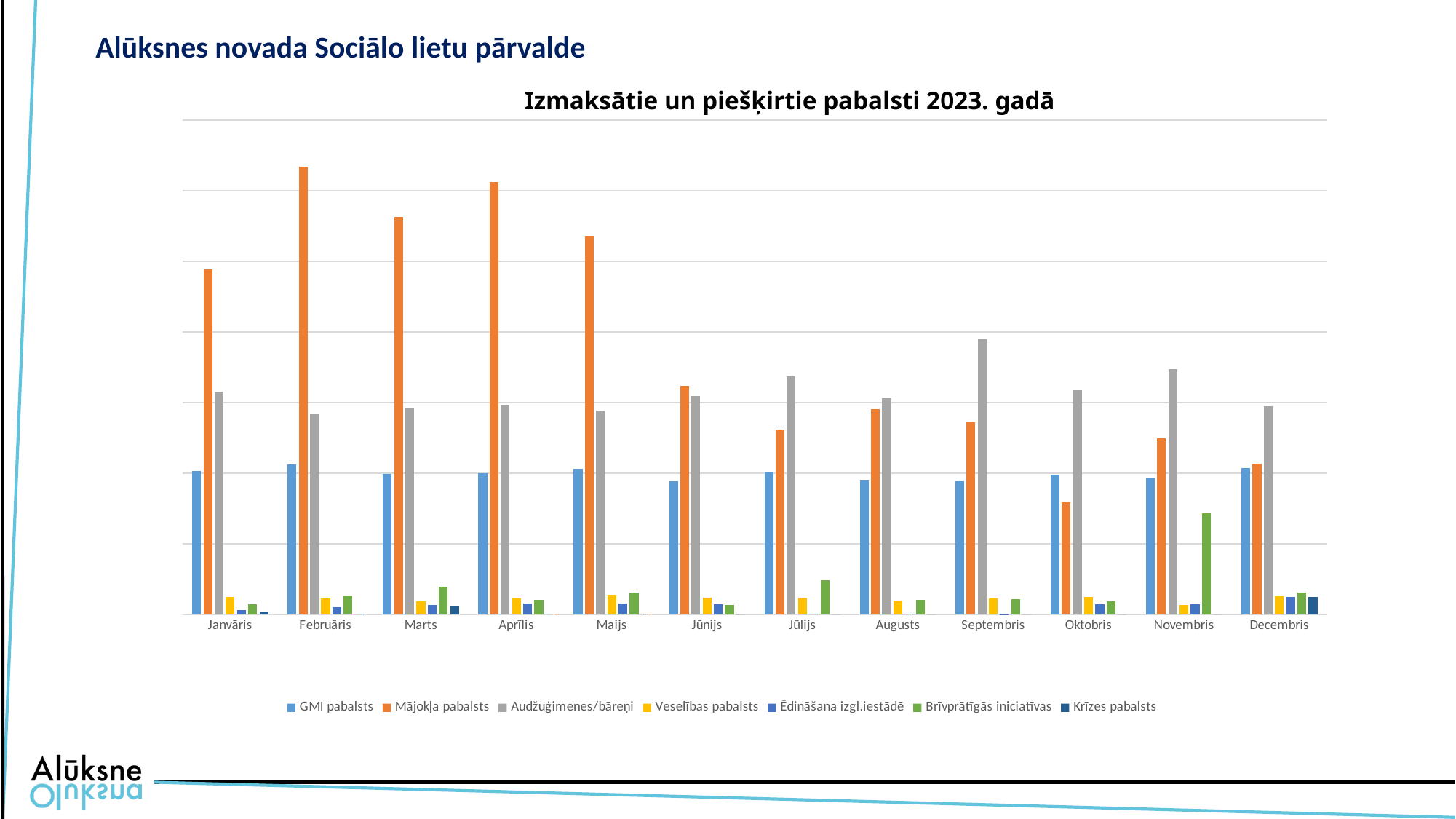
In Janvāris, which is larger: Mājokļa pabalsts or Audžuģimenes/bāreņi? Mājokļa pabalsts In which month is Brīvprātīgās iniciatīvas highest? Novembris What kind of chart is shown on the slide? Bar chart In Septembris, which is larger: Audžuģimenes/bāreņi or Mājokļa pabalsts? Audžuģimenes/bāreņi In which month is Mājokļa pabalsts lowest? Oktobris What is the title of the chart? Izmaksātie un piešķirtie pabalsti 2023. gadā Does Mājokļa pabalsts generally rise or fall from Aprīlis to Oktobris? Fall How many months are shown on the x axis of the chart? 12 In which month is Audžuģimenes/bāreņi highest? Septembris Which series is shown in orange in the chart? Mājokļa pabalsts In which month is Mājokļa pabalsts highest? Februāris How many series does the chart legend list? 7